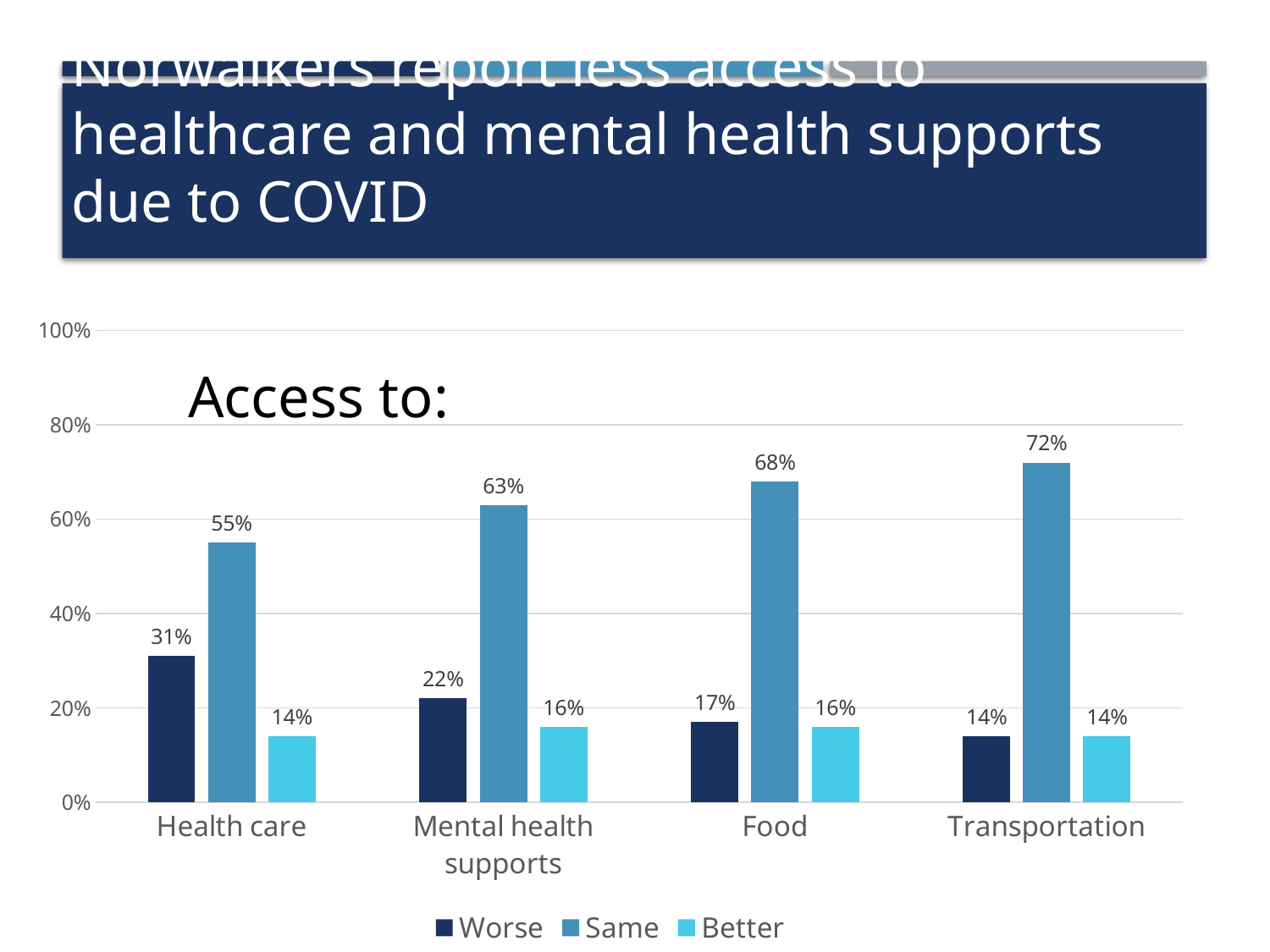
What percentage reported 'Worse' access to Health care? 31% What percentage reported 'Worse' access to Food? 17% What kind of chart is shown on the slide? Bar chart Which is larger: the 'Worse' value for Mental health supports or the 'Worse' value for Transportation? Mental health supports How many categories are shown on the x axis? 4 Is the 'Same' value for Food greater or less than 60%? greater What is the difference between the 'Same' values for Transportation and Health care? 17% Which category has the lowest 'Same' value? Health care How many series does the legend list? 3 What percentage reported 'Same' access to Transportation? 72% Which category has the highest 'Worse' value? Health care What percentage reported 'Better' access to Mental health supports? 16%